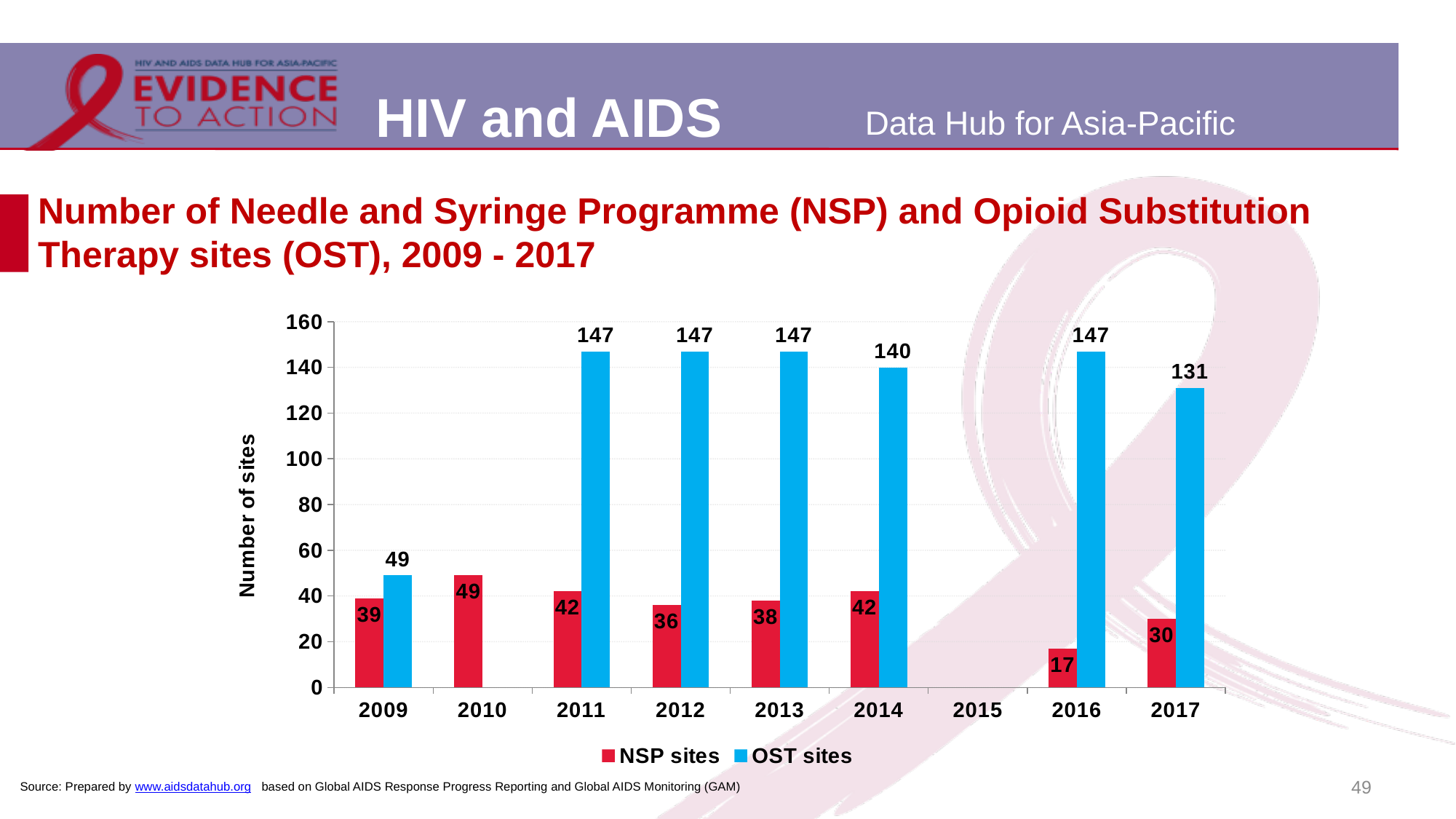
What is the value for OST sites in 2017? 131 In which year was the number of OST sites lowest? 2009 Which year had more NSP sites, 2012 or 2013? 2013 In which year was the number of NSP sites highest? 2010 What kind of chart is shown on the slide? Bar chart How many series does the legend list? 2 How many NSP sites were there in 2016? 17 How many years are shown on the x axis? 9 In which year was the number of NSP sites lowest? 2016 How many OST sites were there in 2014? 140 What is the difference between the number of OST sites and NSP sites in 2017? 101 How many NSP sites were there in 2009? 39